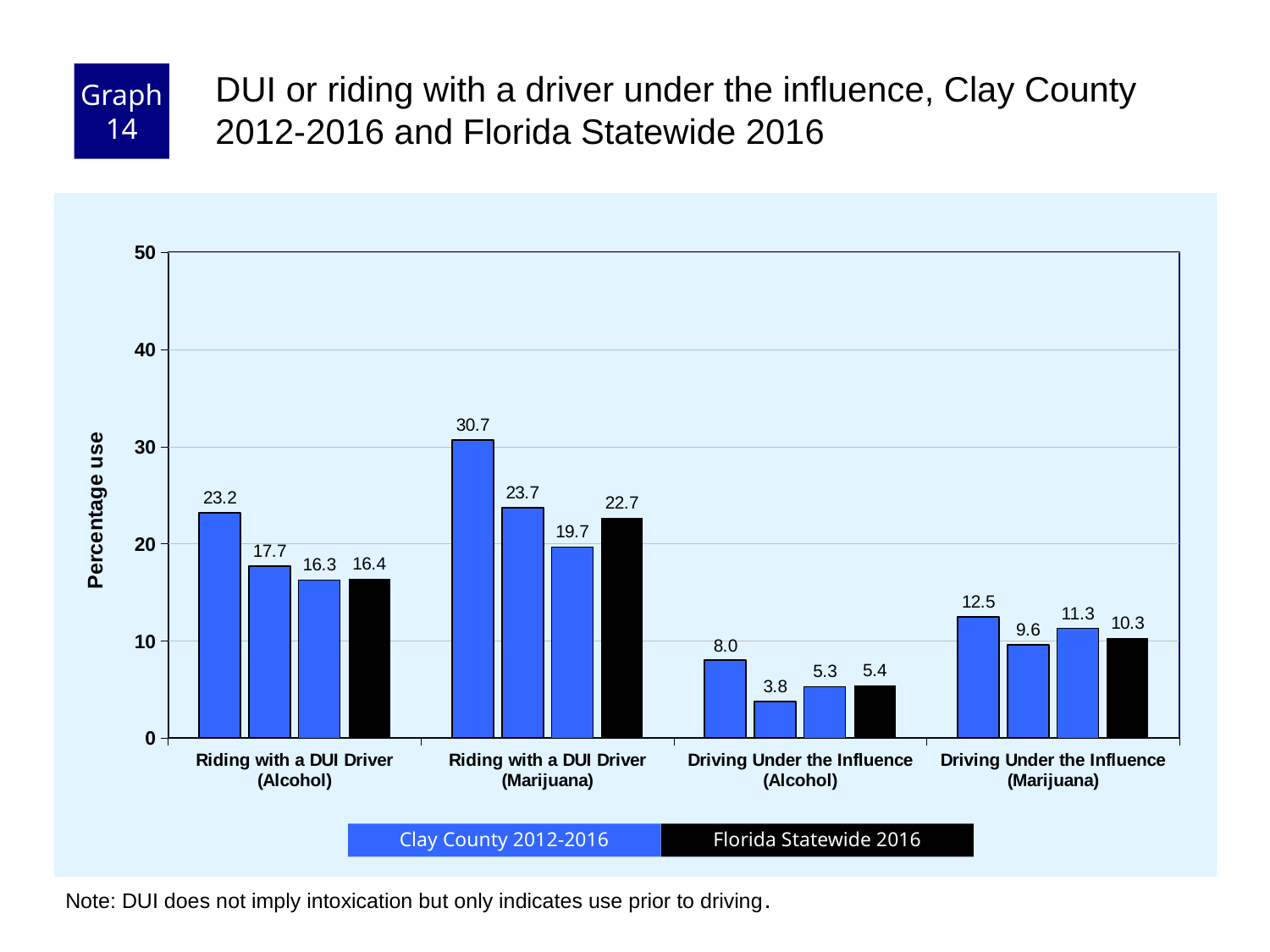
What is the difference between the tallest blue bar (30.7) and the Florida Statewide 2016 bar (22.7) in the Riding with a DUI Driver (Marijuana) group? 8.0 What is the value of the first (leftmost) blue bar in the Driving Under the Influence (Alcohol) group? 8.0 What is the difference between the first blue bar (12.5) and the Florida Statewide 2016 bar (10.3) in the Driving Under the Influence (Marijuana) group? 2.2 What is the highest value shown on the chart? 30.7 How many categories are shown on the x axis? 4 What is the Florida Statewide 2016 value for Riding with a DUI Driver (Marijuana)? 22.7 How many series does the legend list? 2 What is the Florida Statewide 2016 value for Driving Under the Influence (Alcohol)? 5.4 What is the lowest value shown on the chart? 3.8 Which is larger: the Florida Statewide 2016 value for Riding with a DUI Driver (Alcohol) or for Driving Under the Influence (Marijuana)? Riding with a DUI Driver (Alcohol) What kind of chart is shown on the slide? Bar chart Which category has the highest Florida Statewide 2016 value? Riding with a DUI Driver (Marijuana)